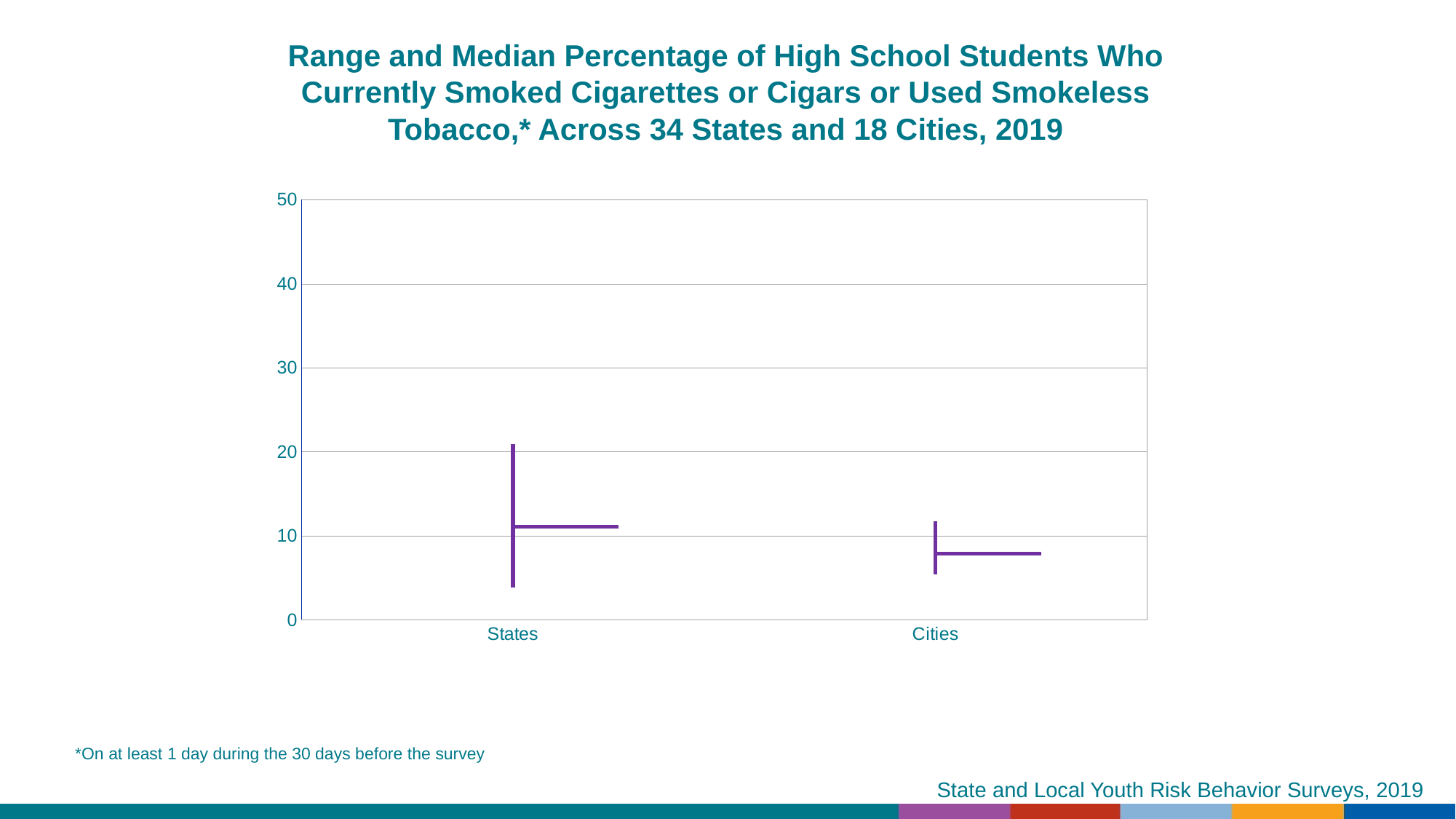
How many categories are shown on the x axis of the chart? 2 Is the bottom of the range for Cities greater or less than 10? less Is the bottom of the range for States greater or less than 10? less Is the top of the range for Cities greater or less than 20? less Which category shows the wider range of percentages? States What are the two categories shown on the x axis? States and Cities Which category has the lowest median percentage? Cities Which category has the higher median percentage, States or Cities? States What is the maximum value shown on the y axis? 50